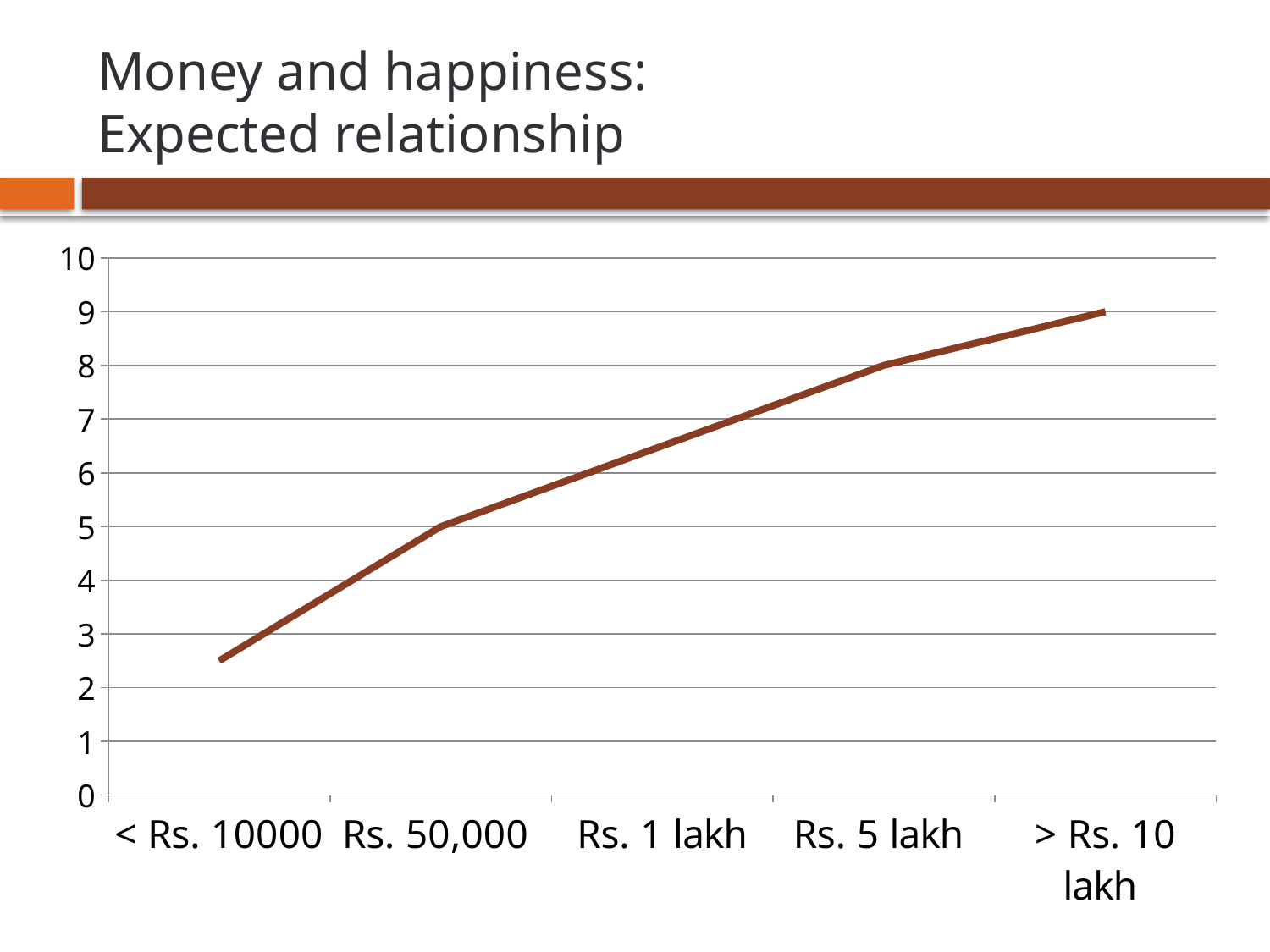
Is the value for < Rs. 10000 greater or less than 3? less What is the difference between the values for Rs. 5 lakh and Rs. 50,000? 3 Which is larger, the value for Rs. 1 lakh or the value for Rs. 5 lakh? Rs. 5 lakh What is the value for Rs. 50,000? 5 Which category has the highest value? > Rs. 10 lakh What is the value for > Rs. 10 lakh? 9 Which category has the lowest value? < Rs. 10000 What type of chart is shown on the slide? line chart How many income categories are plotted on the x axis? 5 Do the values rise or fall as income increases along the x axis? rise What is the value for Rs. 5 lakh? 8